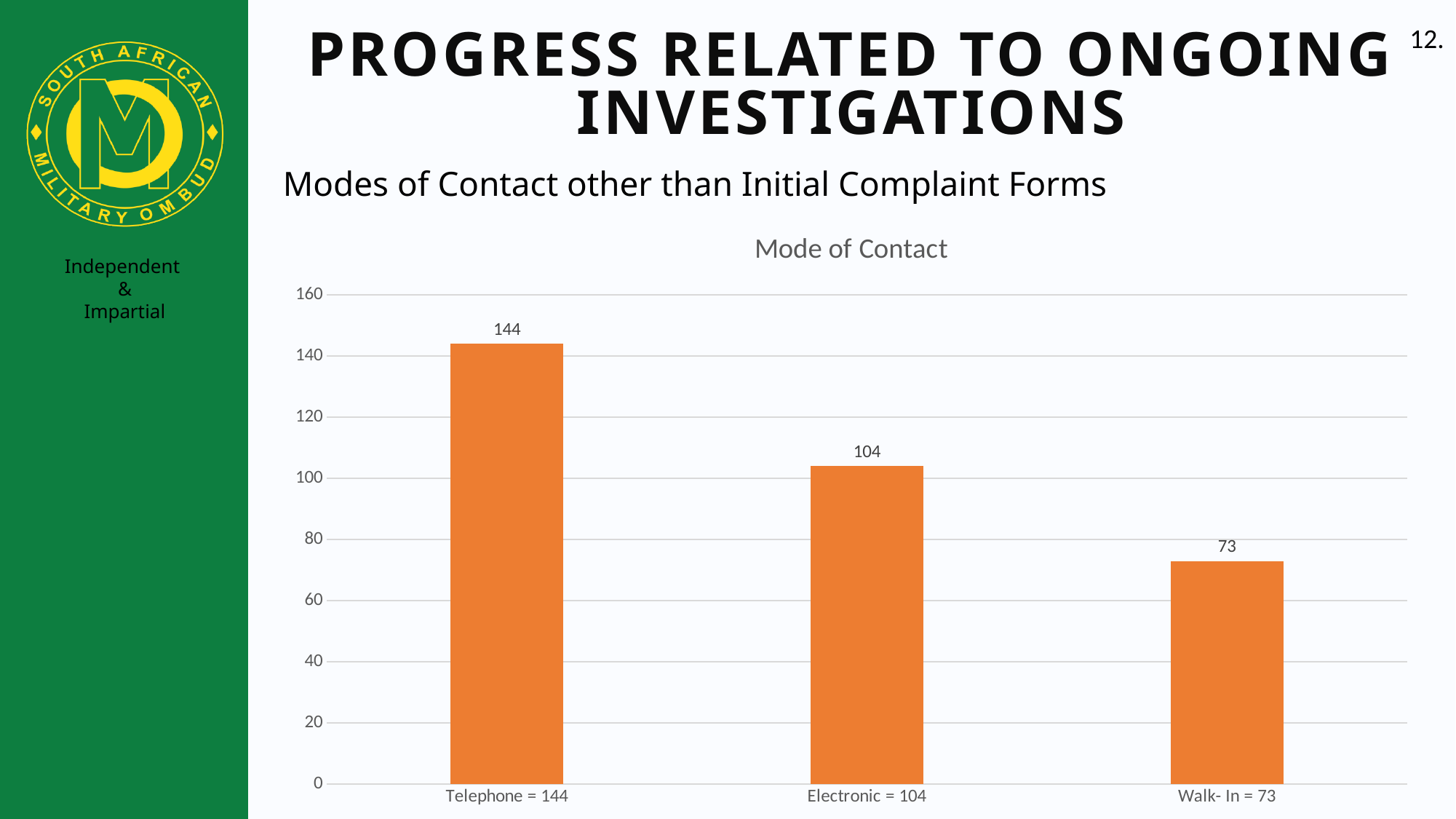
Is the value for Walk-In greater or less than 80? less What kind of chart is shown on the slide? bar chart Which mode of contact has the lowest value? Walk-In Which mode of contact has the highest value? Telephone What is the value for Telephone in the Mode of Contact chart? 144 What is the value for Electronic in the Mode of Contact chart? 104 Which is larger, the value for Electronic or the value for Walk-In? Electronic What is the difference between the Telephone and Electronic values? 40 What is the value for Walk-In in the Mode of Contact chart? 73 What is the difference between the Electronic and Walk-In values? 31 What is the title of the chart? Mode of Contact How many modes of contact are shown in the chart? 3